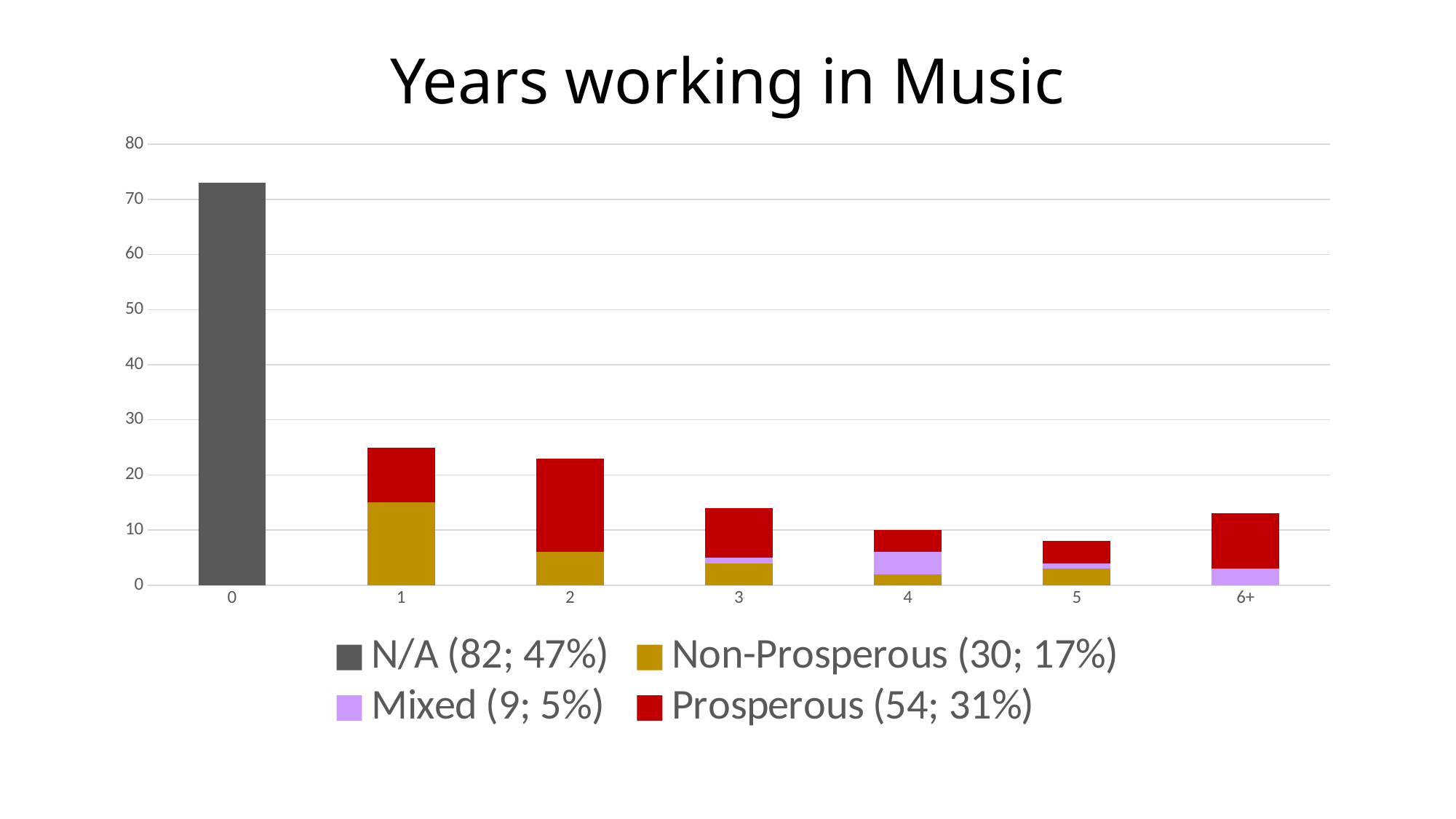
How many series does the legend list? 4 Is the total bar for category 6+ greater or less than 10? greater What kind of chart is shown on the slide? stacked bar chart How many categories are shown on the x axis? 7 Which category has the shortest bar? 5 Which has the taller total bar, category 5 or category 6+? 6+ According to the legend, what percentage is given for the Prosperous series? 31% Is the total bar for category 0 greater or less than 70? greater Is the total bar for category 1 greater or less than 20? greater Which has the taller total bar, category 1 or category 3? 1 Which category has the tallest bar? 0